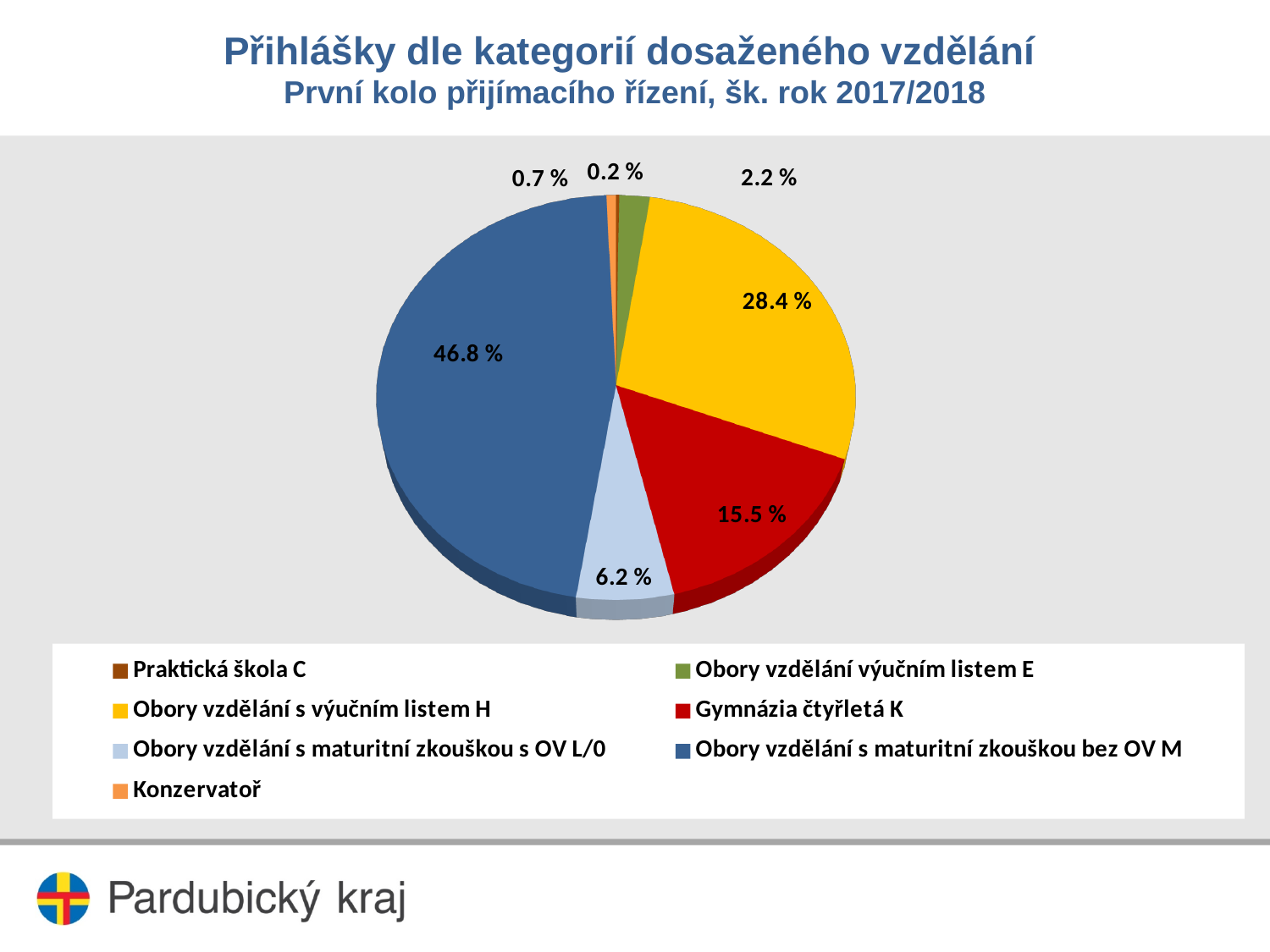
Which category has the largest share of applications? Obory vzdělání s maturitní zkouškou bez OV M What share of applications is for Konzervatoř? 0.7 % What share of applications is for Obory vzdělání s výučním listem H? 28.4 % What share of applications is for Obory vzdělání s maturitní zkouškou bez OV M? 46.8 % Which has a larger share, Gymnázia čtyřletá K or Obory vzdělání s maturitní zkouškou s OV L/0? Gymnázia čtyřletá K What is the difference in percentage points between Obory vzdělání s výučním listem H and Gymnázia čtyřletá K? 12.9 What type of chart is shown on the slide? pie chart What share of applications is for Obory vzdělání s maturitní zkouškou s OV L/0? 6.2 % How many categories does the legend list? 7 Which category has the smallest share of applications? Praktická škola C What share of applications is for Gymnázia čtyřletá K? 15.5 % What colour is the slice for Gymnázia čtyřletá K? red